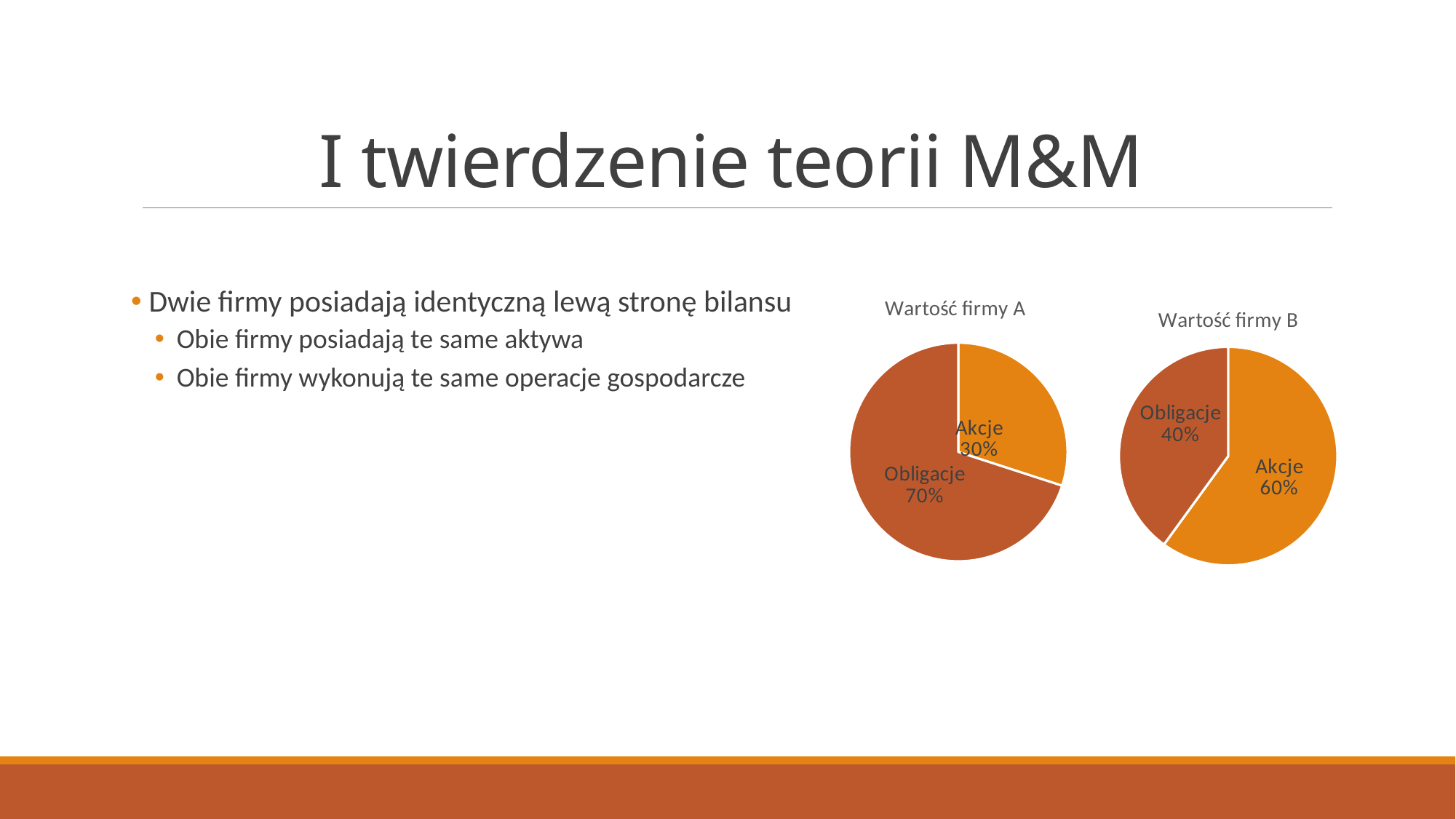
How many slices does the 'Wartość firmy B' chart have? 2 Is the Akcje share larger in the 'Wartość firmy A' chart or in the 'Wartość firmy B' chart? Wartość firmy B How many pie charts are shown on the slide? 2 In the 'Wartość firmy B' chart, what is the difference between the Akcje and Obligacje shares? 20% What kind of chart is 'Wartość firmy A'? Pie chart In the 'Wartość firmy B' chart, what share does Obligacje have? 40% In the 'Wartość firmy A' chart, which slice is the largest? Obligacje In the 'Wartość firmy B' chart, what share does Akcje have? 60% In the 'Wartość firmy A' chart, what is the difference between the Obligacje and Akcje shares? 40% In the 'Wartość firmy A' chart, what share does Obligacje have? 70% In the 'Wartość firmy A' chart, what share does Akcje have? 30% In the 'Wartość firmy B' chart, which slice is the smallest? Obligacje